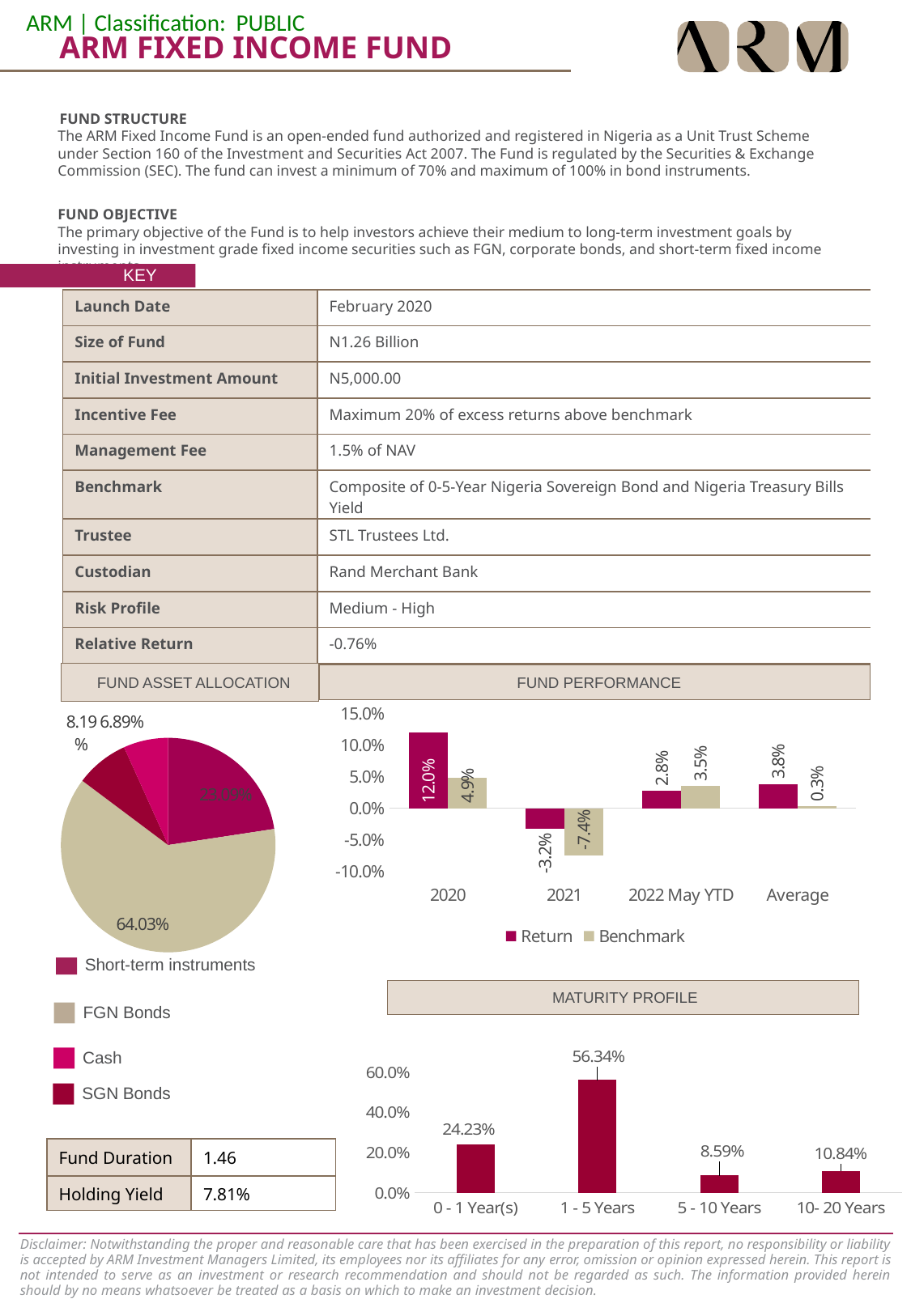
In the Fund Performance chart, for 2022 May YTD, which is larger: the Return or the Benchmark? Benchmark In the Fund Performance chart, what is the difference between the Return and the Benchmark for 2020? 7.1% In the Fund Performance chart, what is the Average Benchmark value? 0.3% In the Maturity Profile chart, which maturity bucket has the lowest value? 5 - 10 Years In the Maturity Profile chart, what is the value for 1 - 5 Years? 56.34% In the Fund Asset Allocation chart, what share of the fund is in FGN Bonds? 64.03% How many series does the legend of the Fund Performance chart list? 2 In the Fund Performance chart, which period has the highest Return? 2020 In the Fund Performance chart, what was the Benchmark value for 2021? -7.4% What type of chart is the Fund Asset Allocation chart? Pie chart In the Fund Performance chart, what was the Return for 2020? 12.0% How many maturity buckets are shown in the Maturity Profile chart? 4